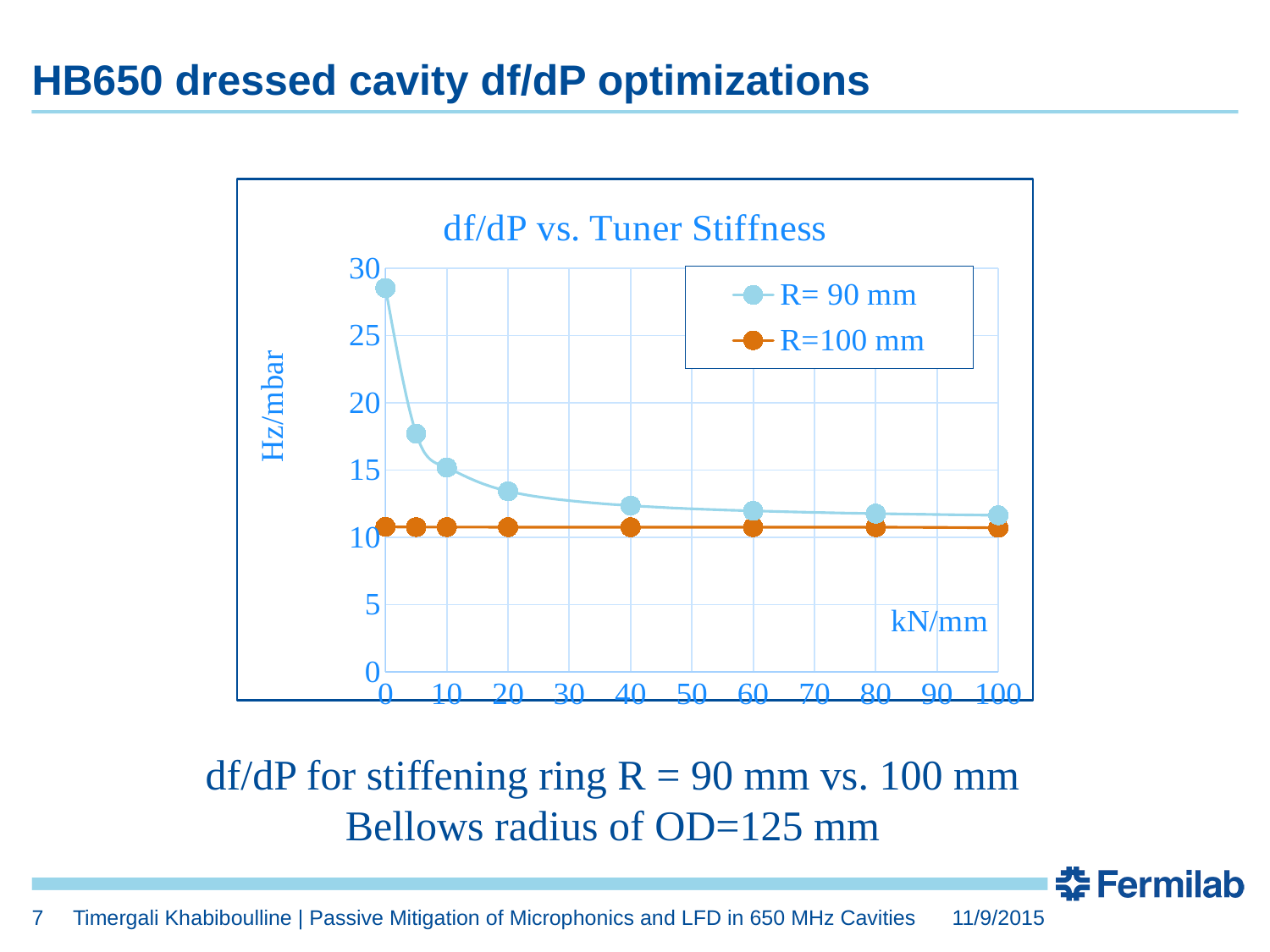
How many data points are plotted for the R= 90 mm series? 8 Is the value for R=100 mm at a tuner stiffness of 40 kN/mm greater or less than 15 Hz/mbar? less How many series does the legend list? 2 Does the R= 90 mm series rise or fall as tuner stiffness increases along the x axis? fall At which tuner stiffness does the R= 90 mm series reach its highest value? 0 kN/mm Does the R=100 mm series rise, fall, or stay roughly flat as tuner stiffness increases? stay roughly flat At a tuner stiffness of 0 kN/mm, which series has the larger df/dP value, R= 90 mm or R=100 mm? R= 90 mm Is the value for R= 90 mm at a tuner stiffness of 0 kN/mm greater or less than 25 Hz/mbar? greater What kind of chart is shown on the slide? line chart What is the title of the chart? df/dP vs. Tuner Stiffness What are the two series named in the legend? R= 90 mm and R=100 mm Is the value for R= 90 mm at a tuner stiffness of 100 kN/mm greater or less than 15 Hz/mbar? less